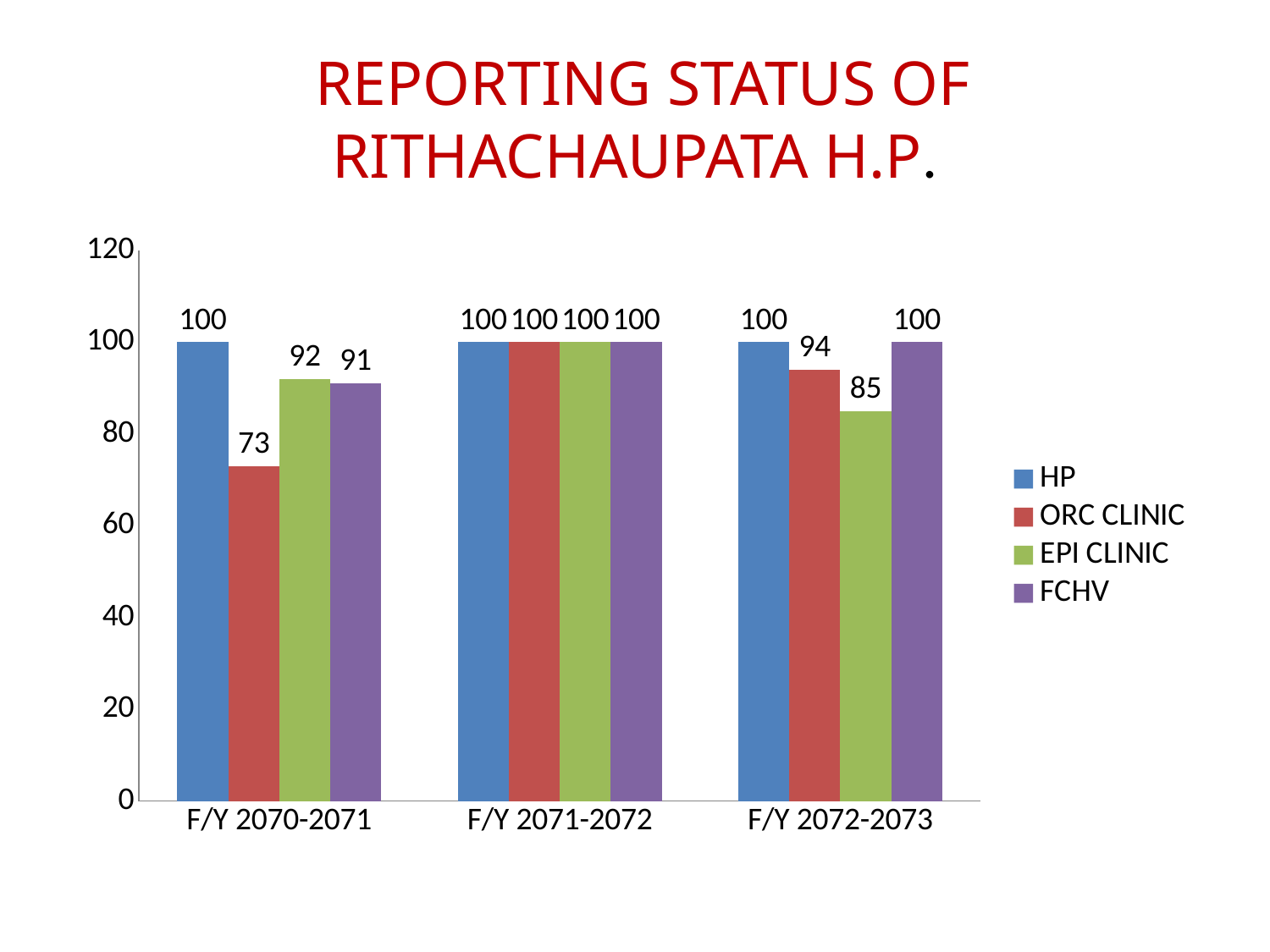
Which is larger in F/Y 2070-2071, the EPI CLINIC value or the ORC CLINIC value? EPI CLINIC Which series has the lowest value in F/Y 2070-2071? ORC CLINIC What is the value for ORC CLINIC in F/Y 2072-2073? 94 What is the difference between the ORC CLINIC and EPI CLINIC values in F/Y 2072-2073? 9 How many series does the legend list? 4 What is the value for EPI CLINIC in F/Y 2072-2073? 85 Which series has the lowest value in F/Y 2072-2073? EPI CLINIC What is the difference between the HP and ORC CLINIC values in F/Y 2070-2071? 27 What is the value for ORC CLINIC in F/Y 2070-2071? 73 What kind of chart is shown on the slide? Bar chart What is the value for FCHV in F/Y 2070-2071? 91 How many fiscal year categories are shown on the x axis? 3